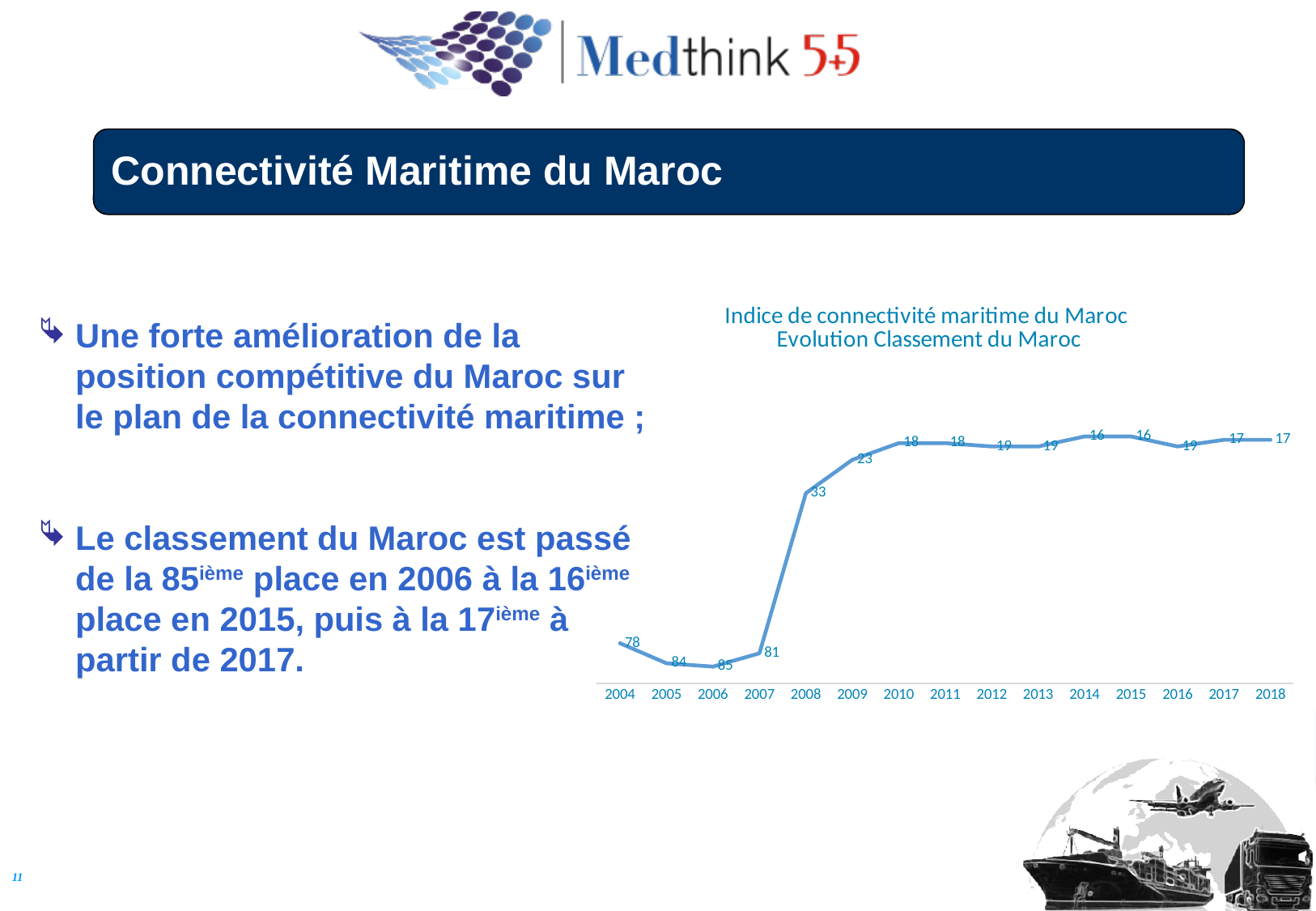
Which is larger, the value for 2009 or the value for 2010? 2009 What is the value for 2006 in the chart? 85 What is the value for 2004 in the chart? 78 What is the value for 2008 in the chart? 33 What is the lowest value shown in the chart? 16 What kind of chart is shown on the slide? Line chart What is the difference between the values for 2007 and 2008? 48 In which year does the chart show the highest value? 2006 What is the value for 2018 in the chart? 17 What is the difference between the values for 2006 and 2015? 69 What is the title of the chart? Indice de connectivité maritime du Maroc Evolution Classement du Maroc How many years are plotted on the x axis of the chart? 15